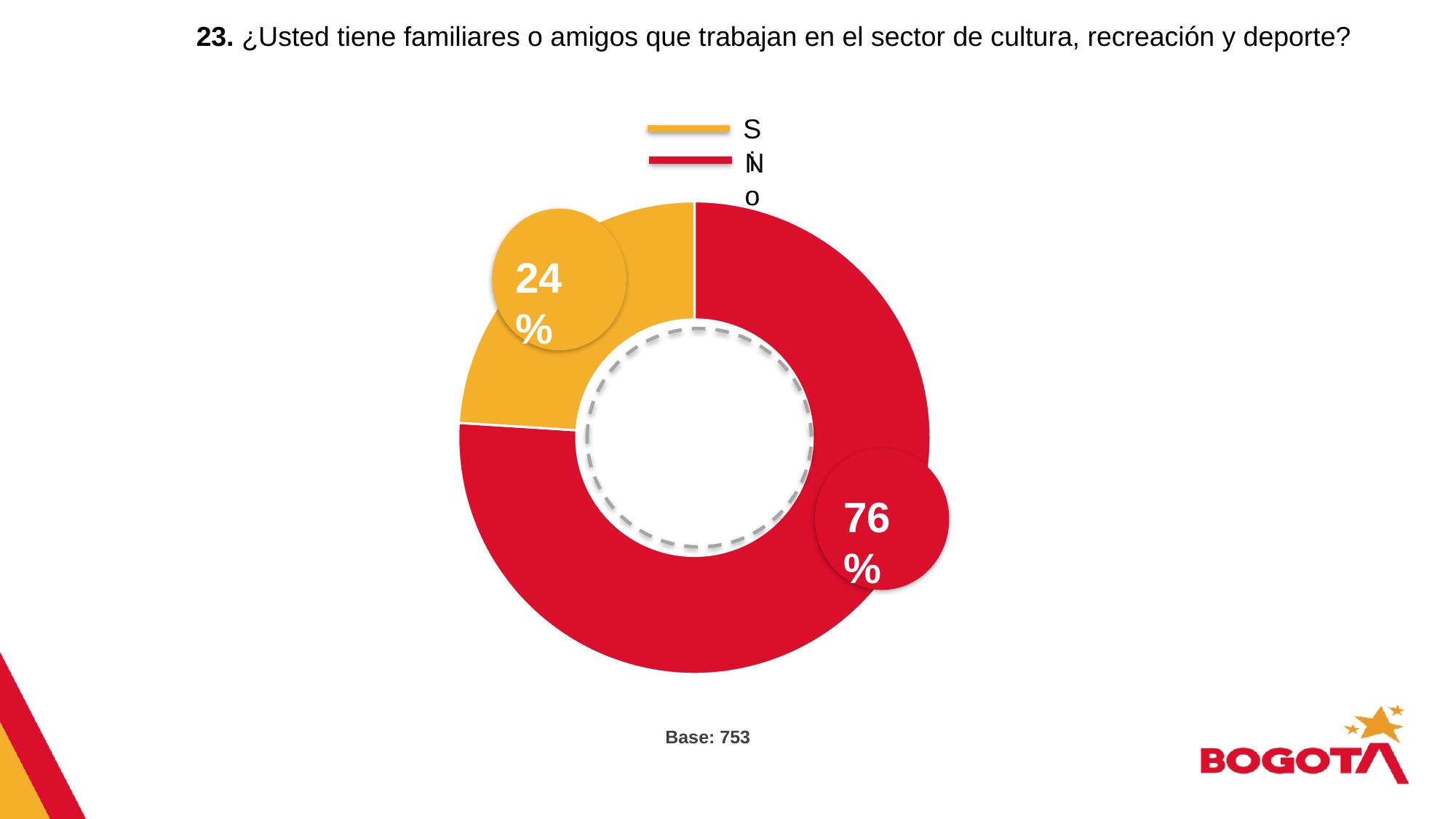
What percentage of respondents answered "No"? 76% How many entries does the legend list? 2 Which response has the smallest share of the chart? Sí What percentage of respondents answered "Sí"? 24% Which is larger, the share for "Sí" or the share for "No"? No What kind of chart is shown on the slide? Donut (pie) chart How many slices does the chart have? 2 What is the difference in percentage points between the "No" and "Sí" responses? 52 percentage points What share of the chart does the "Sí" slice represent? 24% Which response has the largest share of the chart? No What colour represents the "No" response in the chart? Red What is the base (number of respondents) shown below the chart? 753